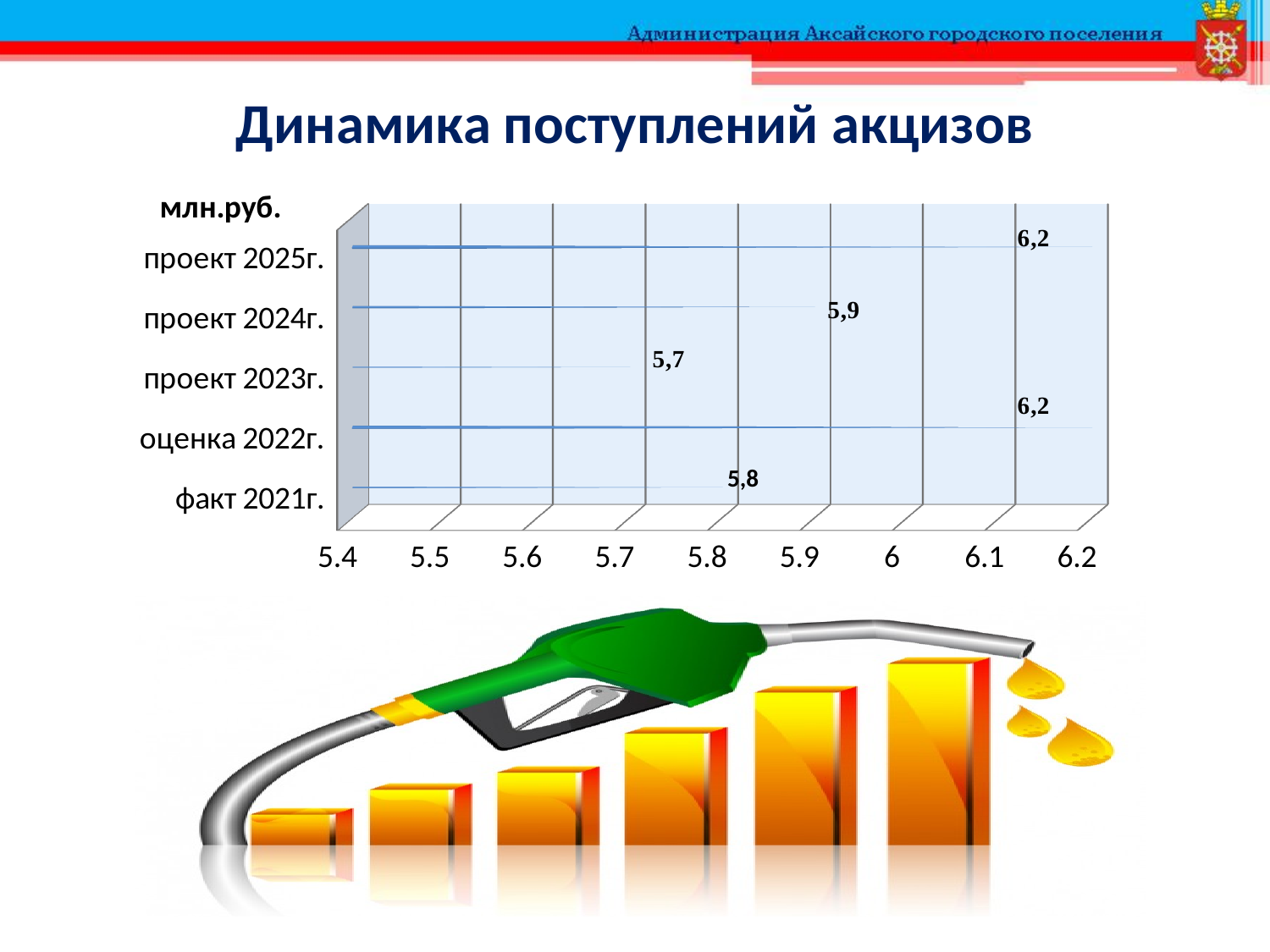
What is the value for проект 2025г.? 6,2 What is the value for проект 2023г.? 5,7 What is the value for факт 2021г.? 5,8 What is the value for проект 2024г.? 5,9 What is the title of the chart? Динамика поступлений акцизов How many categories are shown in the chart? 5 What is the difference between the values for проект 2025г. and проект 2023г.? 0,5 Which category has the lowest value? проект 2023г. What kind of chart is shown on the slide? bar chart Which is larger, the value for проект 2024г. or the value for проект 2023г.? проект 2024г. What is the difference between the values for оценка 2022г. and факт 2021г.? 0,4 What is the value for оценка 2022г.? 6,2